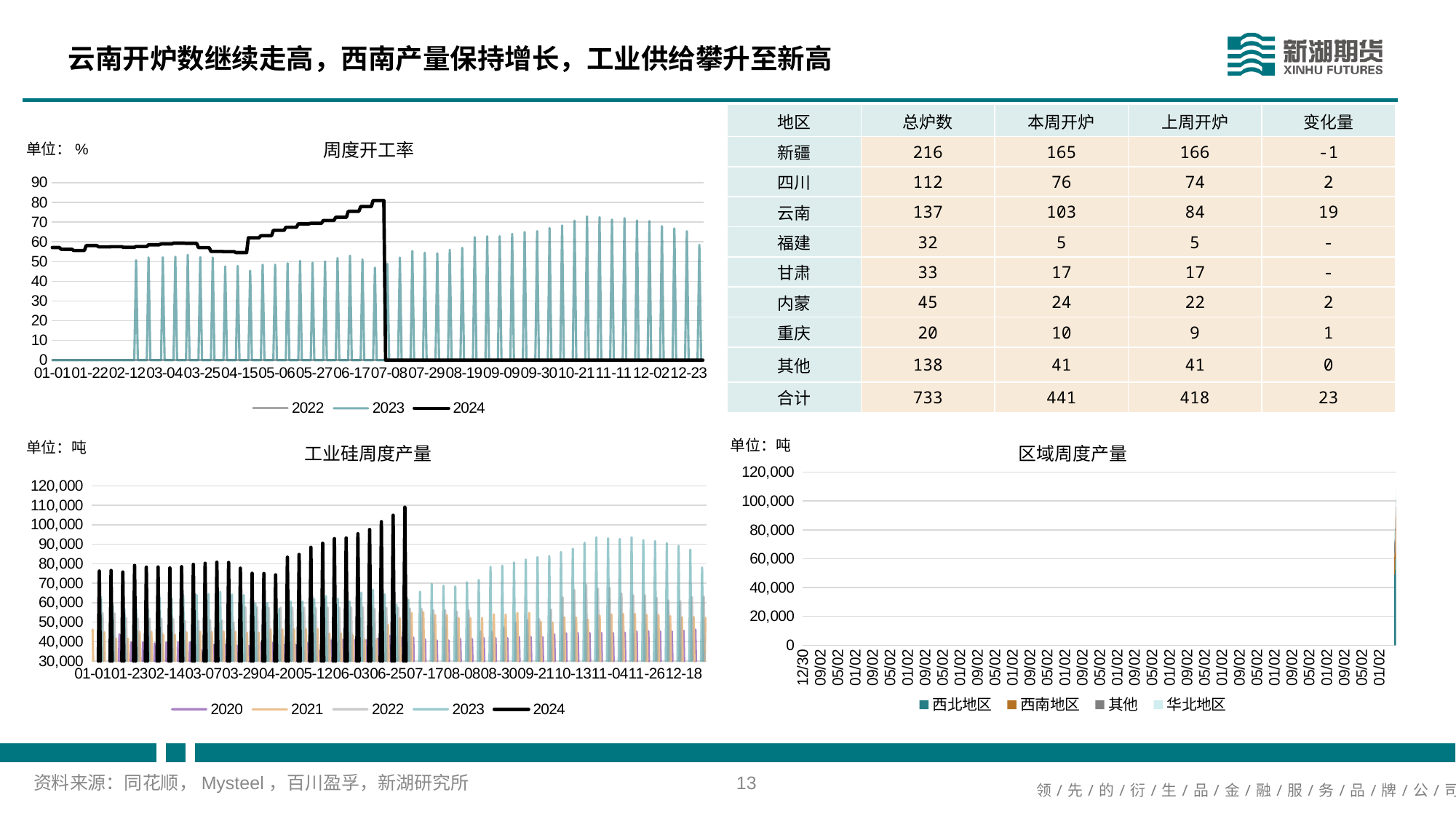
On the 工业硅周度产量 chart, does the 2024 series rise or fall from 04-20 to 06-25? rise On the 周度开工率 chart, is the 2024 value at 01-01 greater or less than 50? greater On the 区域周度产量 chart, what is the highest value shown on the vertical axis? 120,000 On the 工业硅周度产量 chart, what is the lowest value shown on the vertical axis? 30,000 On the 周度开工率 chart, what kind of chart is it? line chart On the 工业硅周度产量 chart, is the highest 2024 value greater or less than 100,000? greater On the 区域周度产量 chart, how many series does the legend list? 4 On the 工业硅周度产量 chart, what unit is shown for the values? 吨 On the 周度开工率 chart, is the highest 2024 value greater or less than 70? greater On the 周度开工率 chart, how many series does the legend list? 3 On the 工业硅周度产量 chart, how many series does the legend list? 5